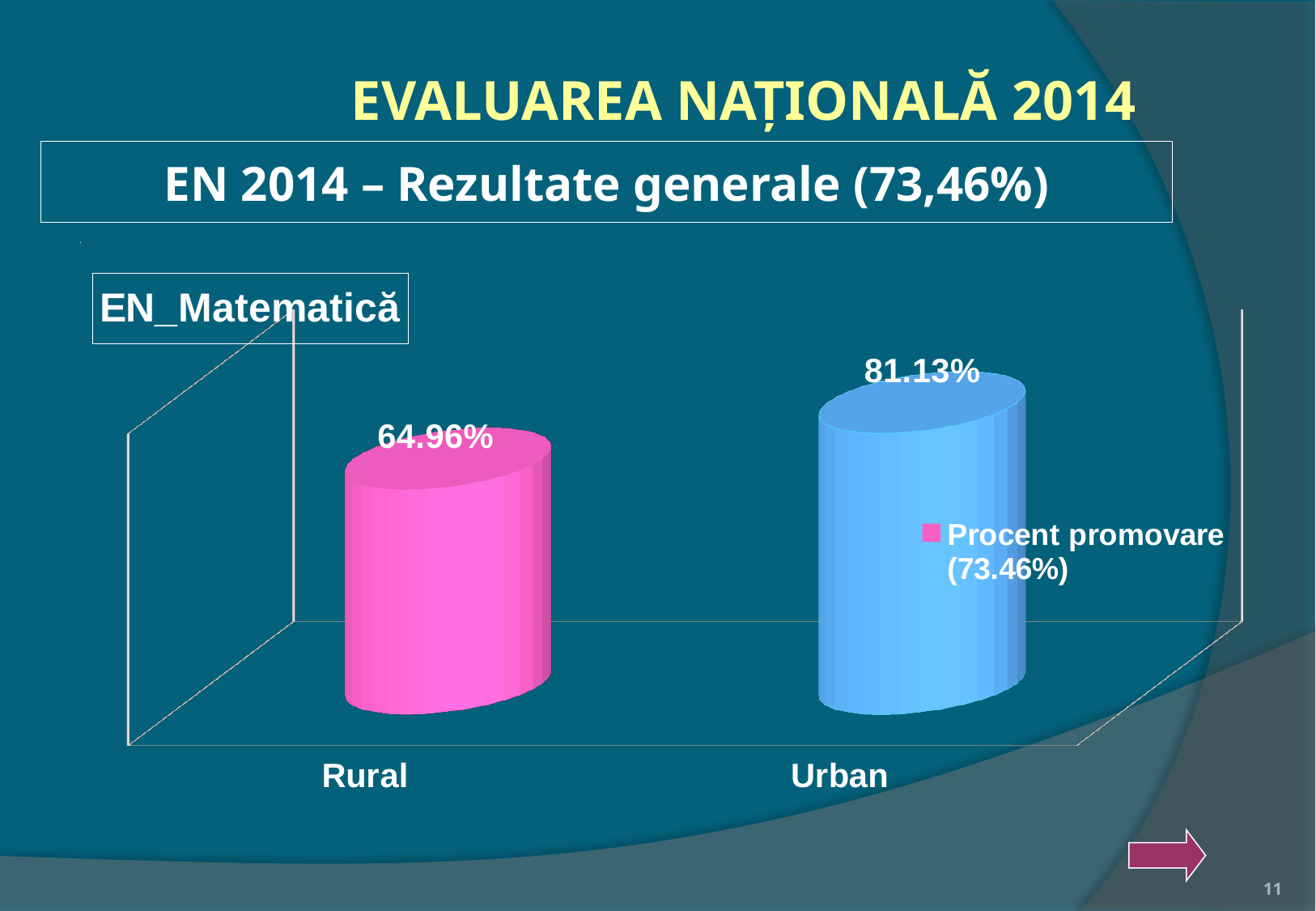
Which category has the highest value? Urban How many series does the legend list? 1 Which is larger, the value for Rural or the value for Urban? Urban What is the value for Urban? 81.13% Do the values rise or fall from Rural to Urban? rise What is the legend entry of the chart? Procent promovare (73.46%) What is the title of the chart? EN_Matematică Which category has the lowest value? Rural What is the value for Rural? 64.96% How many categories are shown on the x axis? 2 What kind of chart is shown? bar chart What is the difference between the Urban and Rural values? 16.17%